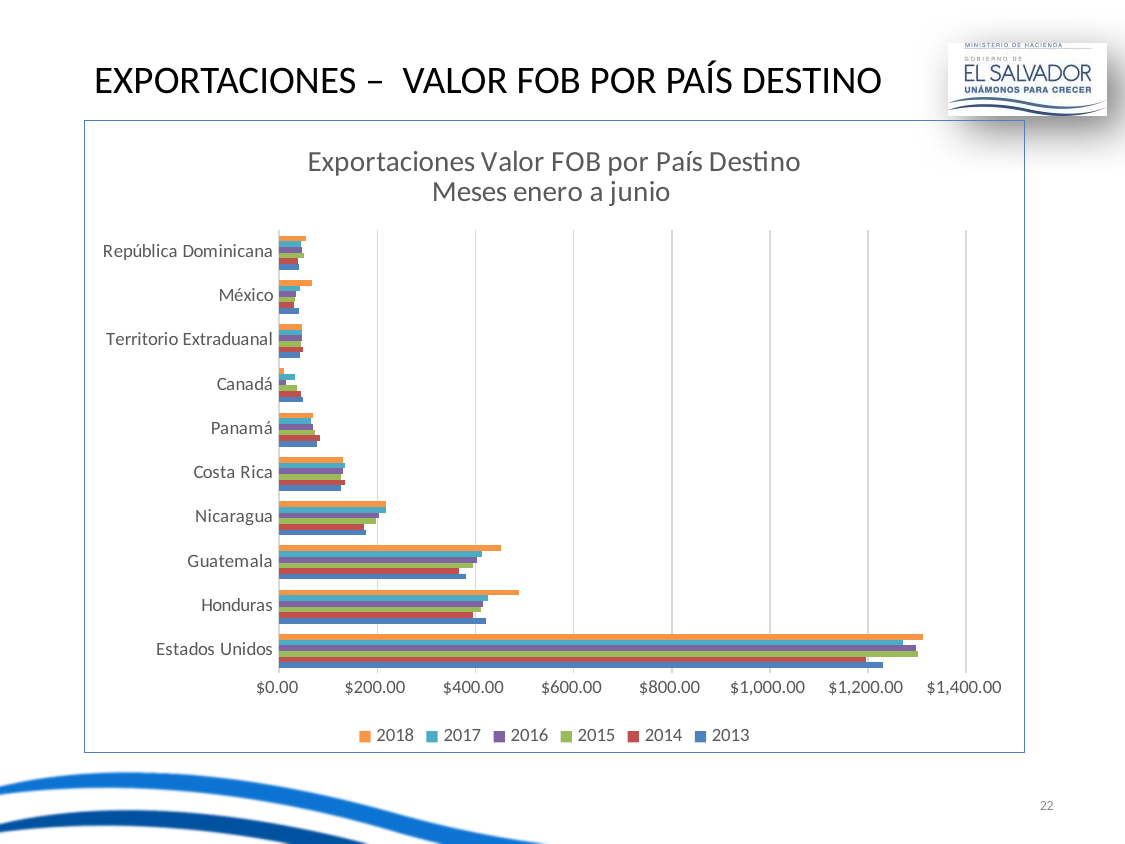
Which is larger in 2018, the value for Nicaragua or the value for Costa Rica? Nicaragua Is the 2018 value for Honduras greater or less than $400.00? greater How many series does the chart's legend list? 6 Is the 2018 value for Estados Unidos greater or less than $1,200.00? greater Which is larger in 2018, the value for Honduras or the value for Guatemala? Honduras How many countries/destinations are listed on the chart's vertical axis? 10 Is the 2018 value for Costa Rica greater or less than $200.00? less Which destination has the highest export value in 2018? Estados Unidos Do the values for Canadá rise or fall from 2013 to 2018? fall What kind of chart is shown on the slide? Bar chart Which destination has the lowest export value in 2018? Canadá What is the title of the chart? Exportaciones Valor FOB por País Destino Meses enero a junio